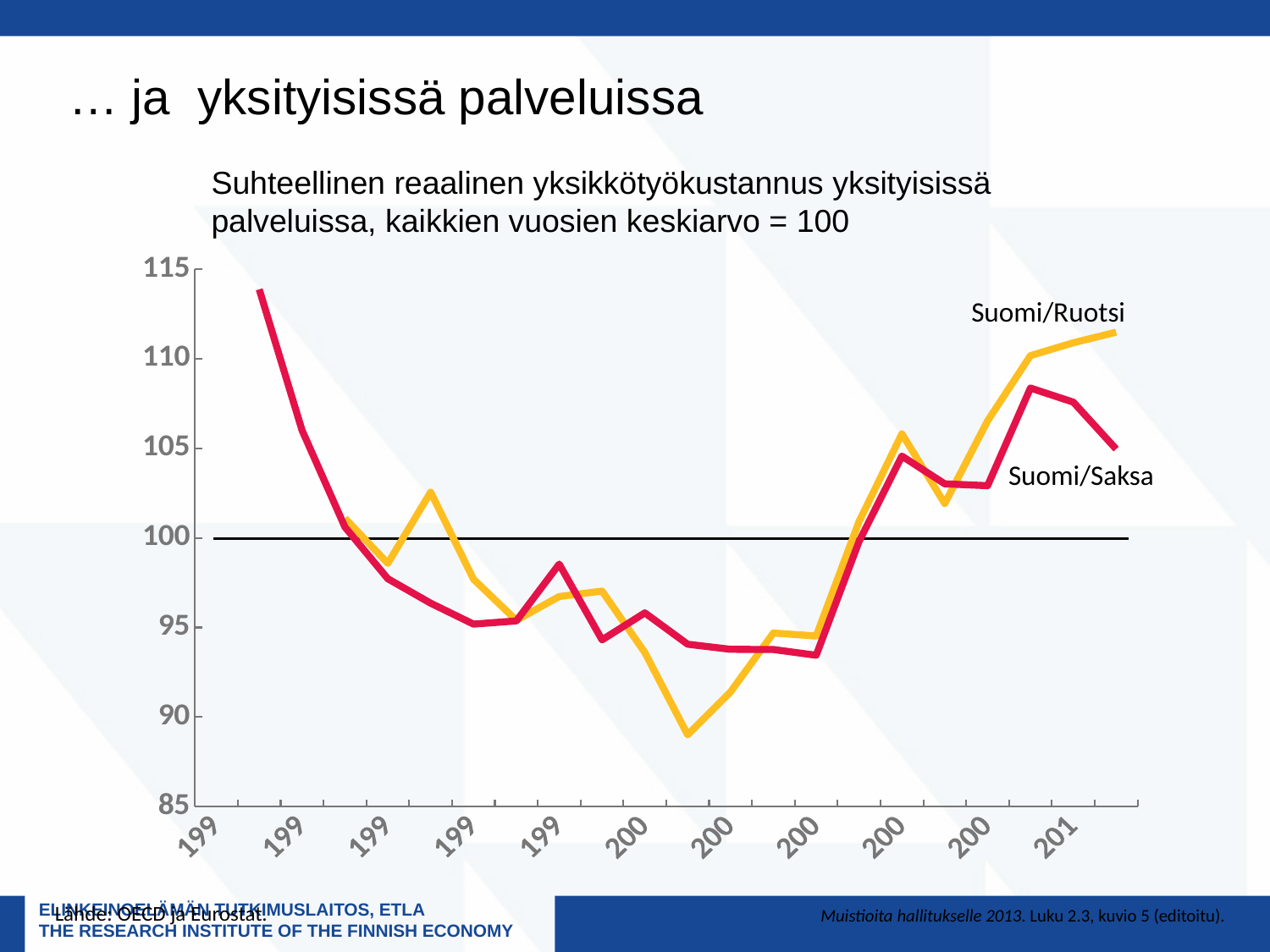
Is the first plotted value of the Suomi/Saksa series greater or less than 110? greater Is the last plotted value of the Suomi/Saksa series greater or less than 100? greater At what value is the horizontal reference line drawn on the chart? 100 Which series is drawn in yellow? Suomi/Ruotsi Which series reaches the lowest point anywhere on the chart? Suomi/Ruotsi Is the last plotted value of the Suomi/Ruotsi series greater or less than 110? greater What is the highest value shown on the vertical axis? 115 What kind of chart is shown on the slide? line chart Over the last few points, does the Suomi/Ruotsi series rise or fall? rise At the right end of the chart, which series has the higher value, Suomi/Ruotsi or Suomi/Saksa? Suomi/Ruotsi How many series are plotted on the chart? 2